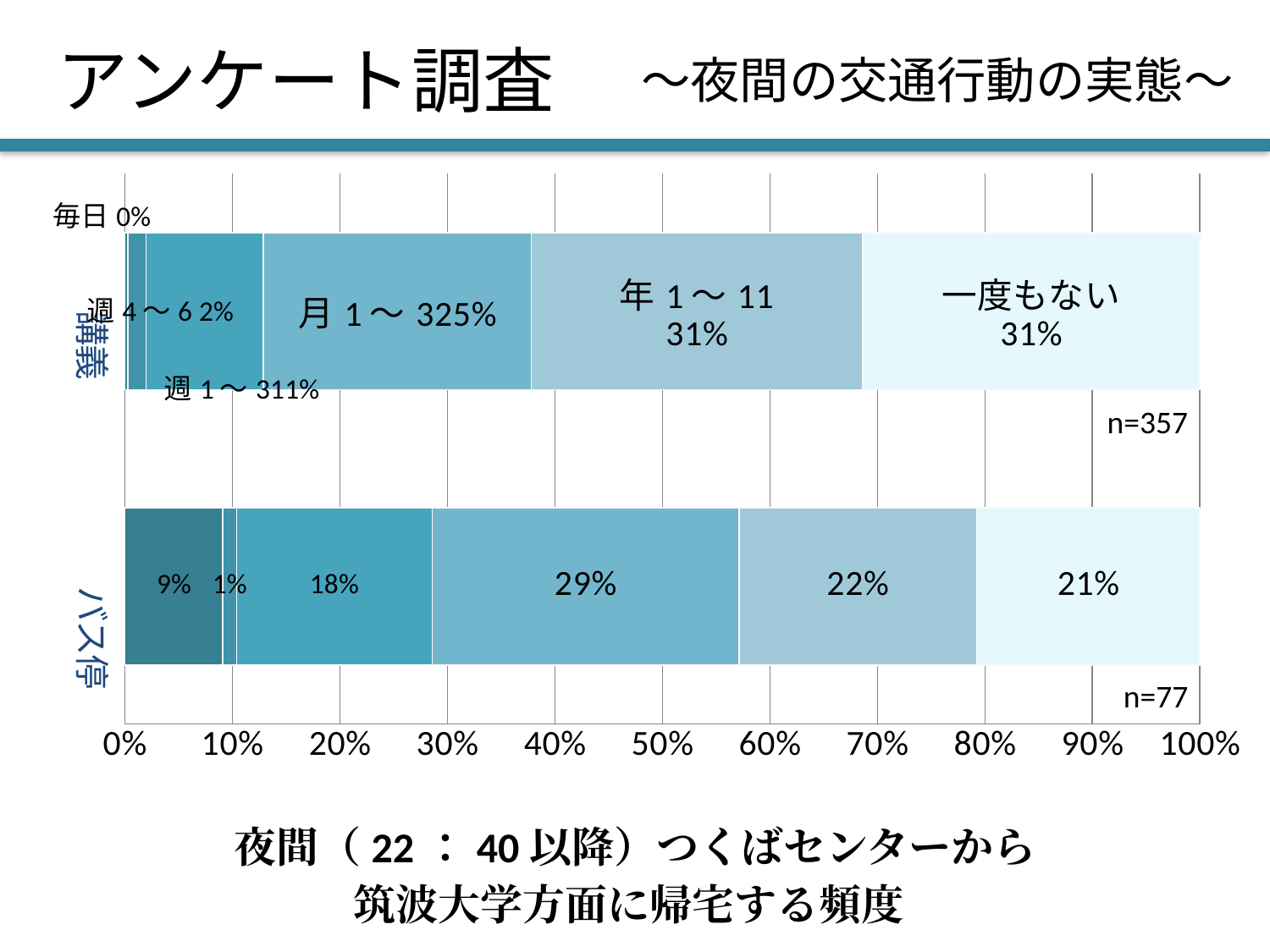
What is the value of the 毎日 (darkest) segment for バス停? 9% Which segment is the smallest in the バス停 bar? 週4〜6 (1%) Which segment is the largest in the バス停 bar? 月1〜3 (29%) What is the value of 毎日 for 講義? 0% How many categories (bars) does the chart show? 2 What is the sample size (n) shown for the 講義 bar? n=357 What is the value of 一度もない for 講義? 31% What is the difference between the 一度もない values for 講義 and バス停? 10% What kind of chart is shown on the slide? stacked bar chart What is the value of the 月1〜3 segment for バス停? 29% Which is larger: the 週1〜3 value for 講義 or for バス停? バス停 What is the value of 月1〜3 for 講義? 25%